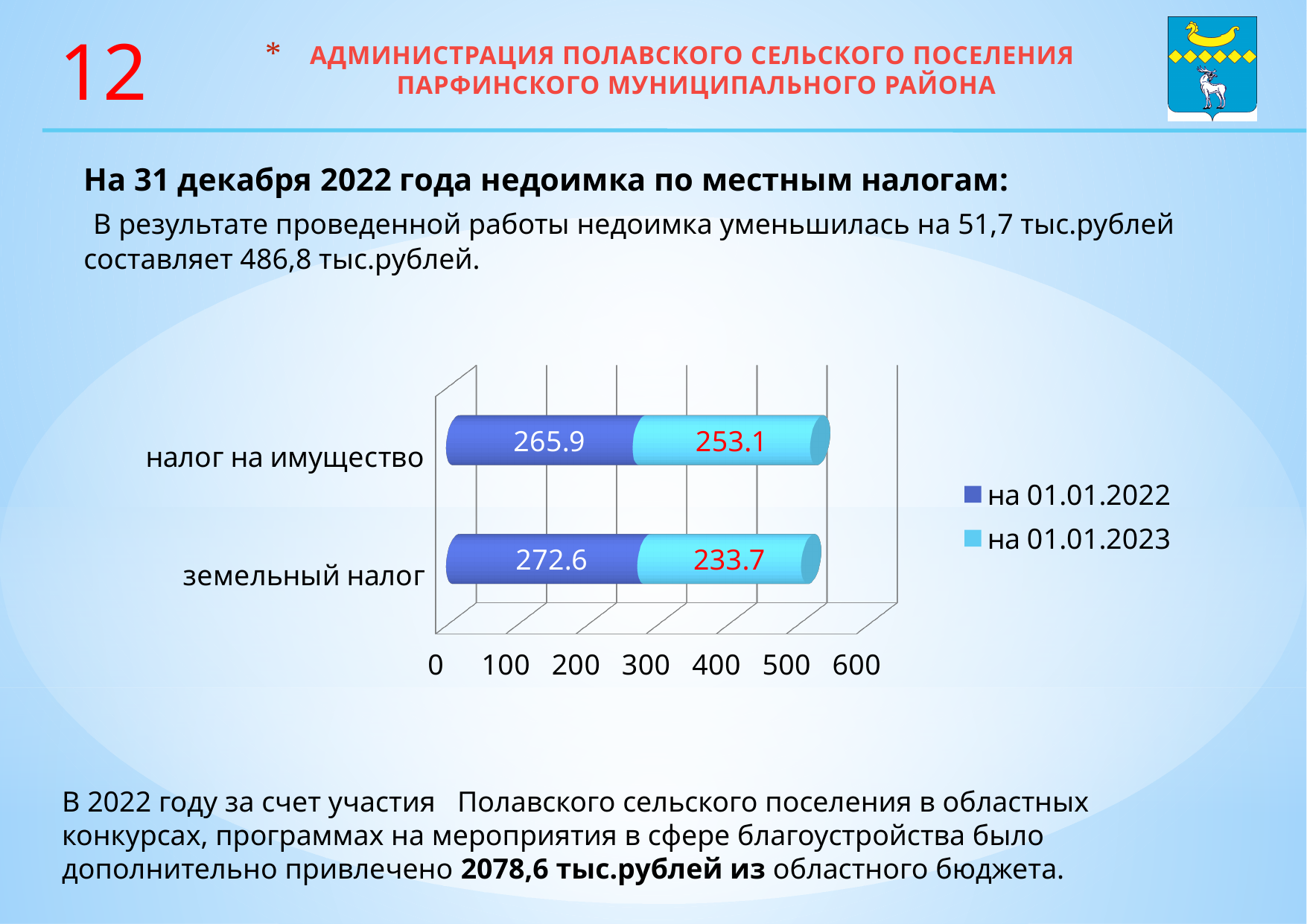
Which category has the higher value in the series на 01.01.2022? земельный налог What is the value for земельный налог in the series на 01.01.2023? 233.7 What kind of chart is shown on the slide? bar chart Is the value for налог на имущество on 01.01.2022 larger or smaller than its value on 01.01.2023? larger How many categories are shown on the chart? 2 How many series does the legend list? 2 What is the difference between the на 01.01.2022 and на 01.01.2023 values for земельный налог? 38.9 What is the total of the stacked bar for налог на имущество? 519.0 What is the value for земельный налог in the series на 01.01.2022? 272.6 Which category has the lower value in the series на 01.01.2023? земельный налог What is the value for налог на имущество in the series на 01.01.2023? 253.1 What is the value for налог на имущество in the series на 01.01.2022? 265.9